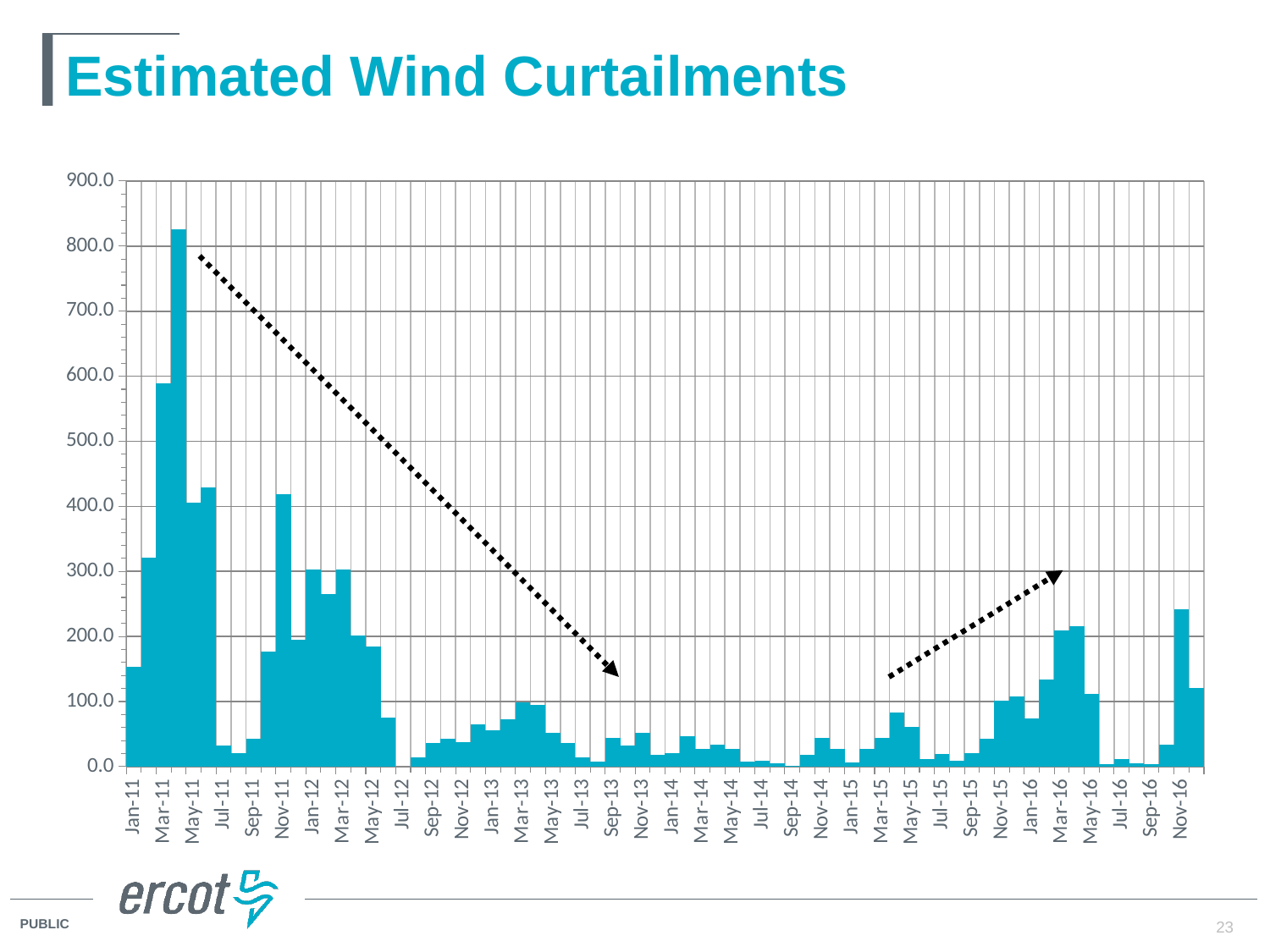
Is the value for Jul-12 greater or less than 100? less Is the value for Nov-11 greater or less than 300? greater Is the value for Jan-11 greater or less than 100? greater Which is larger, the value for Mar-11 or the value for Nov-16? Mar-11 What kind of chart is shown on the slide? bar chart According to the dotted arrow, do the values generally rise or fall from early 2011 to late 2013? fall In which year does the tallest bar of the chart occur? 2011 What is the title of the chart? Estimated Wind Curtailments What is the highest value shown on the vertical axis? 900.0